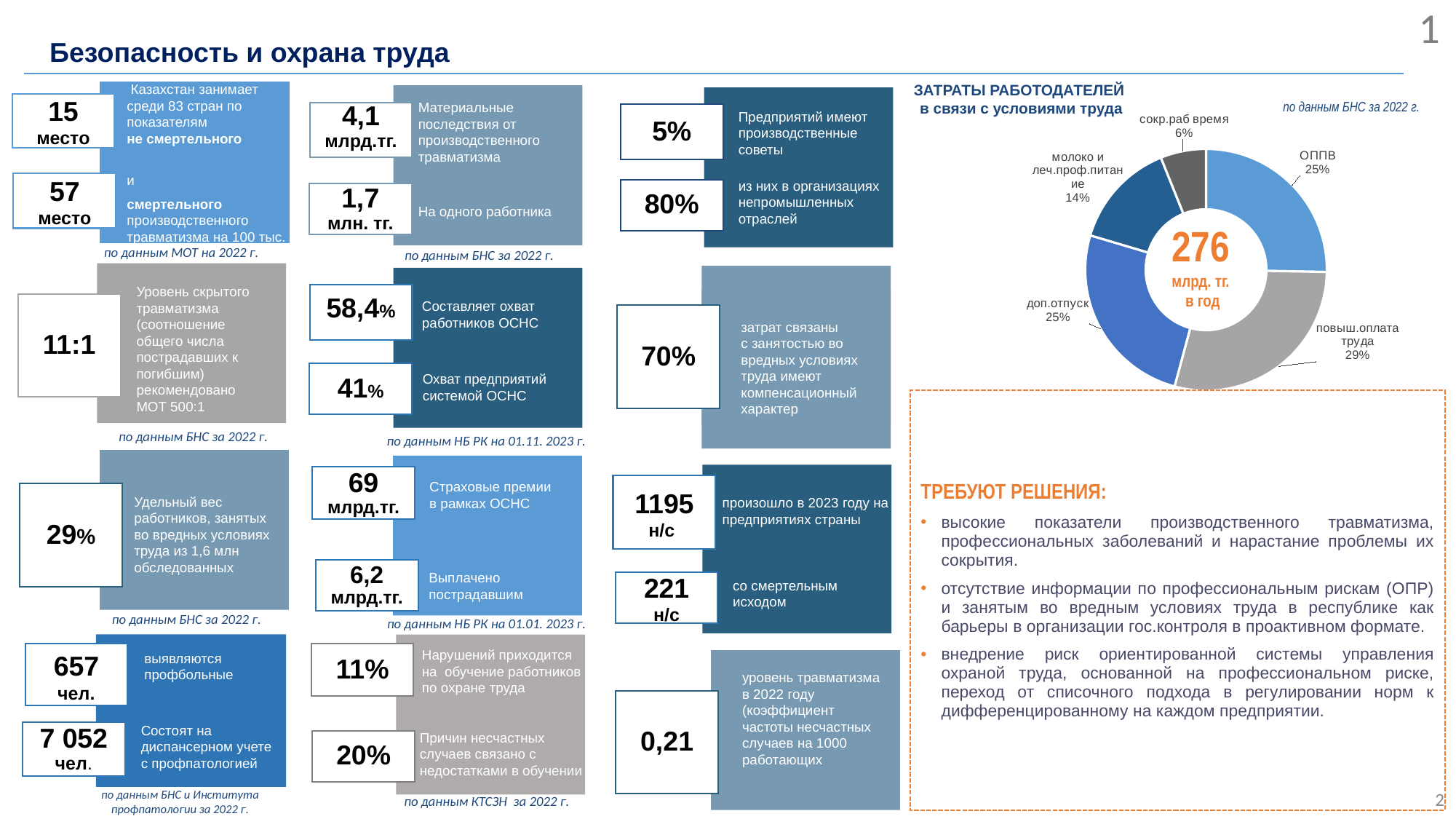
What kind of chart is shown under the title 'ЗАТРАТЫ РАБОТОДАТЕЛЕЙ в связи с условиями труда'? Doughnut (pie) chart In the 'ЗАТРАТЫ РАБОТОДАТЕЛЕЙ' chart, which is larger: 'доп.отпуск' or 'сокр.раб время'? доп.отпуск In the 'ЗАТРАТЫ РАБОТОДАТЕЛЕЙ' chart, what share is labelled for 'ОППВ'? 25% What total value is printed in the centre of the 'ЗАТРАТЫ РАБОТОДАТЕЛЕЙ' chart? 276 млрд. тг. в год In the 'ЗАТРАТЫ РАБОТОДАТЕЛЕЙ' chart, what share is labelled for 'молоко и леч.проф.питание'? 14% According to the note next to the 'ЗАТРАТЫ РАБОТОДАТЕЛЕЙ' chart, what is the data source and year? по данным БНС за 2022 г. In the 'ЗАТРАТЫ РАБОТОДАТЕЛЕЙ' chart, which category has the largest share? повыш.оплата труда How many slices does the 'ЗАТРАТЫ РАБОТОДАТЕЛЕЙ' chart have? 5 In the 'ЗАТРАТЫ РАБОТОДАТЕЛЕЙ' chart, what share is labelled for 'сокр.раб время'? 6% In the 'ЗАТРАТЫ РАБОТОДАТЕЛЕЙ' chart, what share is labelled for 'повыш.оплата труда'? 29% In the 'ЗАТРАТЫ РАБОТОДАТЕЛЕЙ' chart, how many percentage points larger is 'повыш.оплата труда' than 'молоко и леч.проф.питание'? 15 percentage points In the 'ЗАТРАТЫ РАБОТОДАТЕЛЕЙ' chart, which category has the smallest share? сокр.раб время